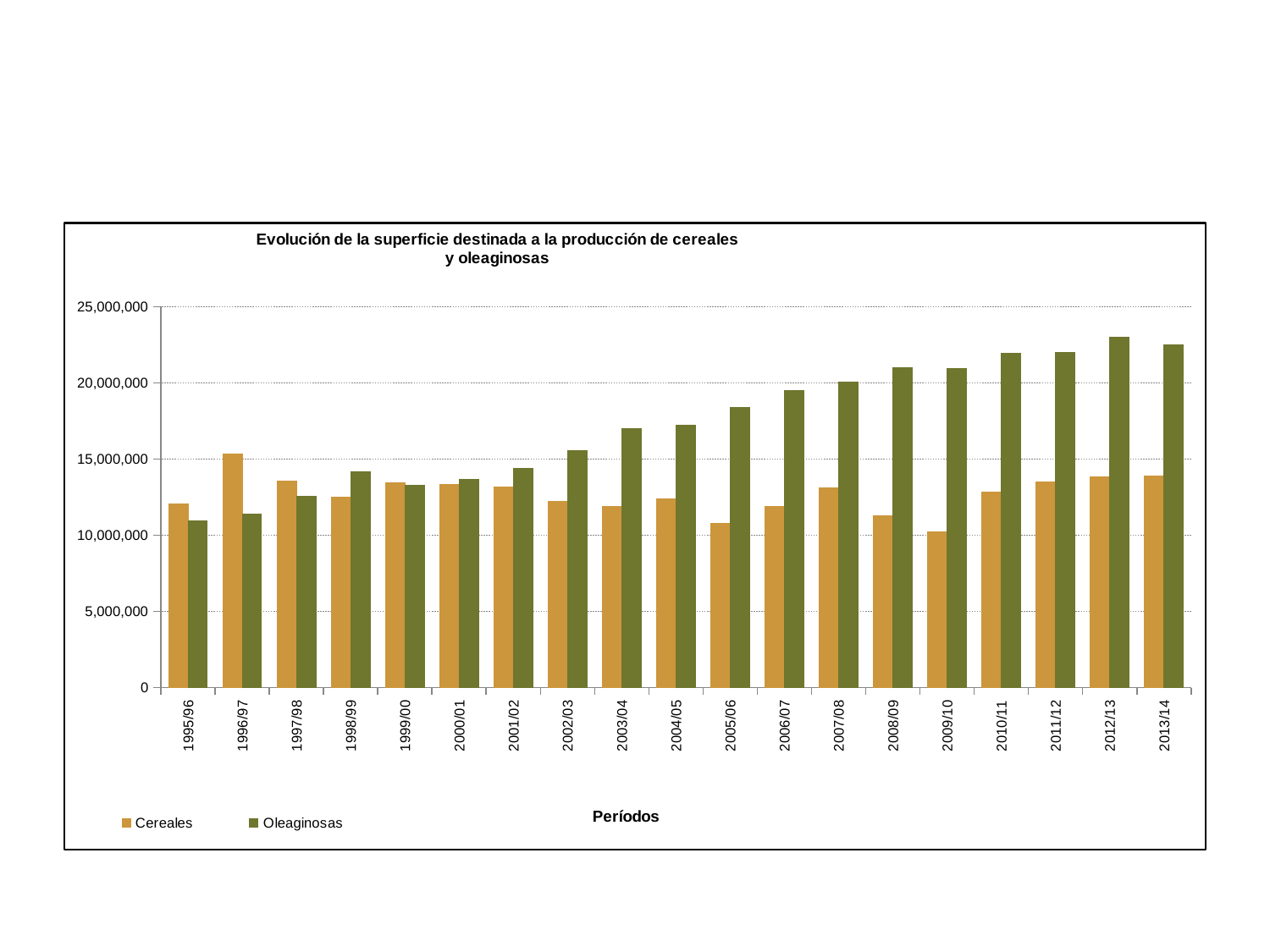
How many series does the legend list? 2 What kind of chart is shown on the slide? bar chart Is the value for Cereales in 1996/97 greater or less than 15,000,000? greater Do the values for Oleaginosas generally rise or fall from 1995/96 to 2013/14? rise Is the value for Oleaginosas in 2003/04 greater or less than 20,000,000? less In 1996/97, which series has the larger value, Cereales or Oleaginosas? Cereales Which period has the highest value for Cereales? 1996/97 How many periods are shown on the x axis? 19 Is the value for Cereales in 2005/06 greater or less than 15,000,000? less In 2013/14, which series has the larger value, Cereales or Oleaginosas? Oleaginosas Which period has the lowest value for Cereales? 2009/10